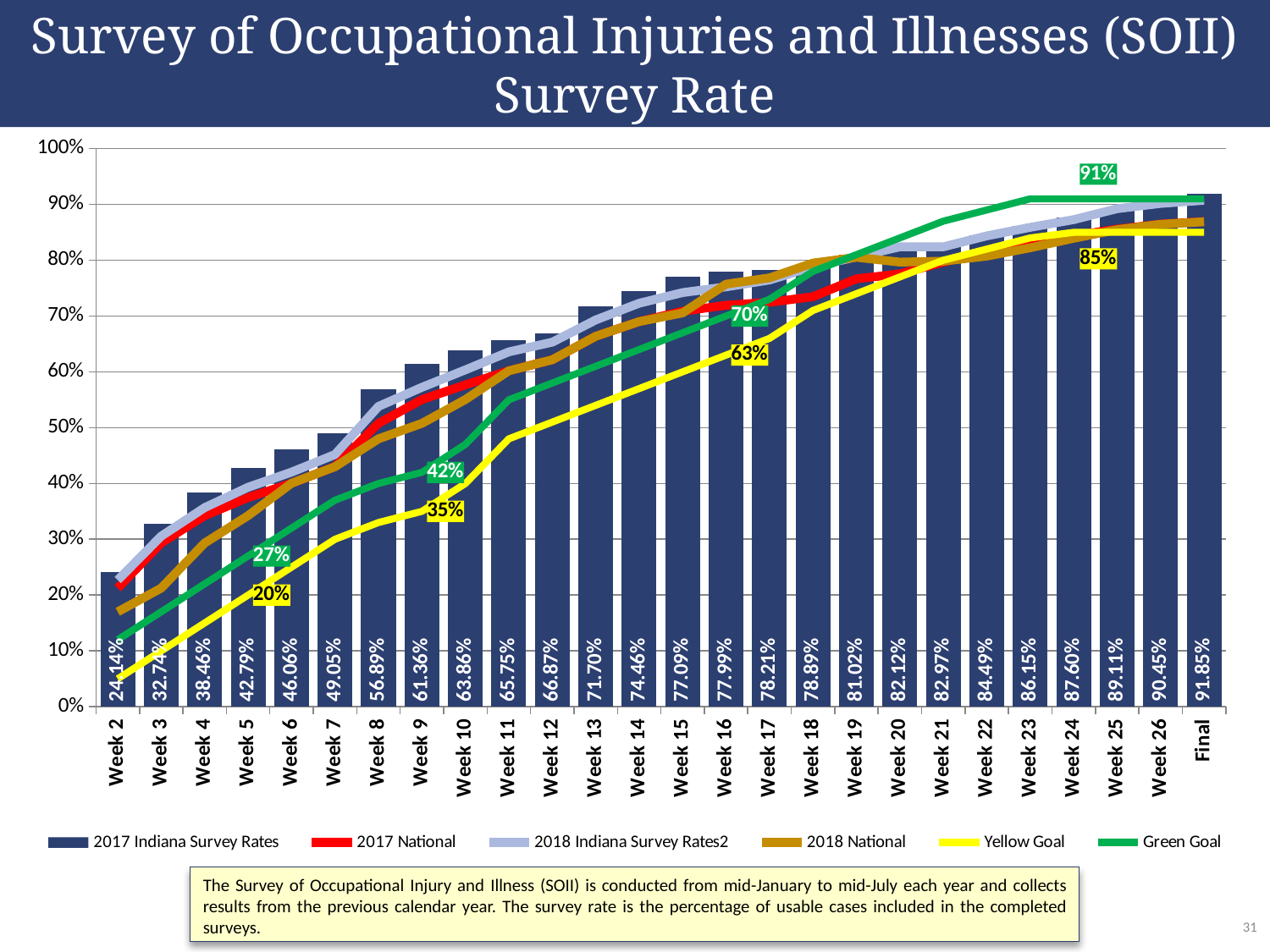
What is the 2017 Indiana Survey Rate for Week 2? 24.14% What is the 2017 Indiana Survey Rate for Week 13? 71.70% Which is larger, the 2017 Indiana Survey Rate for Week 8 or for Week 6? Week 8 What is the difference between the 2017 Indiana Survey Rate for Final and for Week 2? 67.71% Which week has the lowest 2017 Indiana Survey Rate bar? Week 2 What Green Goal value is labelled near Week 24? 91% Do the 2017 Indiana Survey Rates rise or fall from Week 2 to Final? rise How many categories are shown along the x axis? 26 Which category has the highest 2017 Indiana Survey Rate bar? Final How many series does the legend list? 6 What is the 2017 Indiana Survey Rate labelled for Final? 91.85%